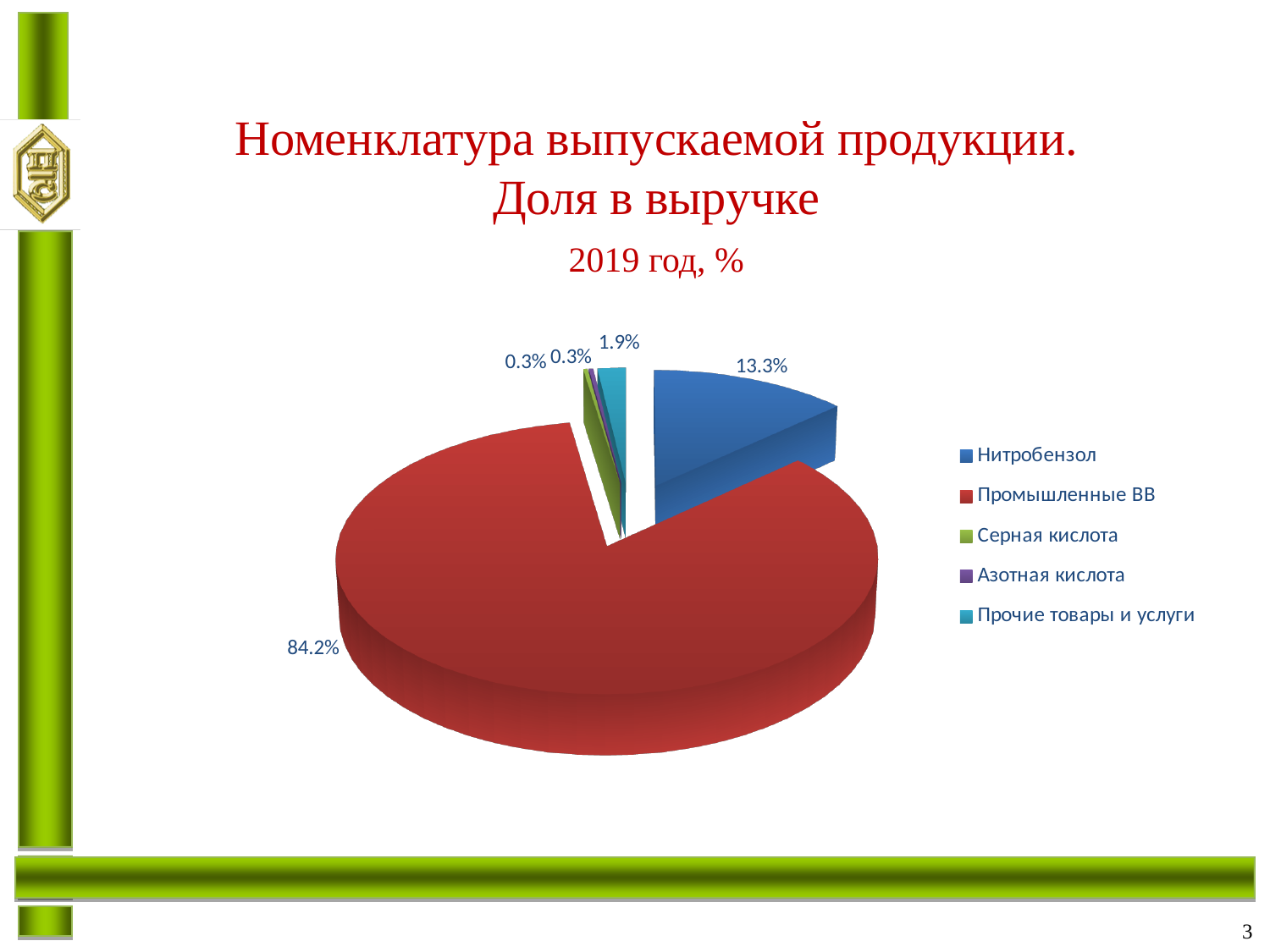
What is the value shown for Нитробензол? 13.3% Which is larger, the share for Нитробензол or the share for Прочие товары и услуги? Нитробензол Which colour represents Промышленные ВВ in the chart? Red What kind of chart is shown on the slide? Pie chart What is the value shown for Прочие товары и услуги? 1.9% Which year does the chart refer to, according to the subtitle? 2019 What is the value shown for Азотная кислота? 0.3% What share of revenue does Промышленные ВВ account for in the pie chart? 84.2% What is the difference in percentage points between Промышленные ВВ and Нитробензол? 70.9 Which category has the largest share of revenue? Промышленные ВВ How many categories does the pie chart show? 5 What is the value shown for Серная кислота? 0.3%